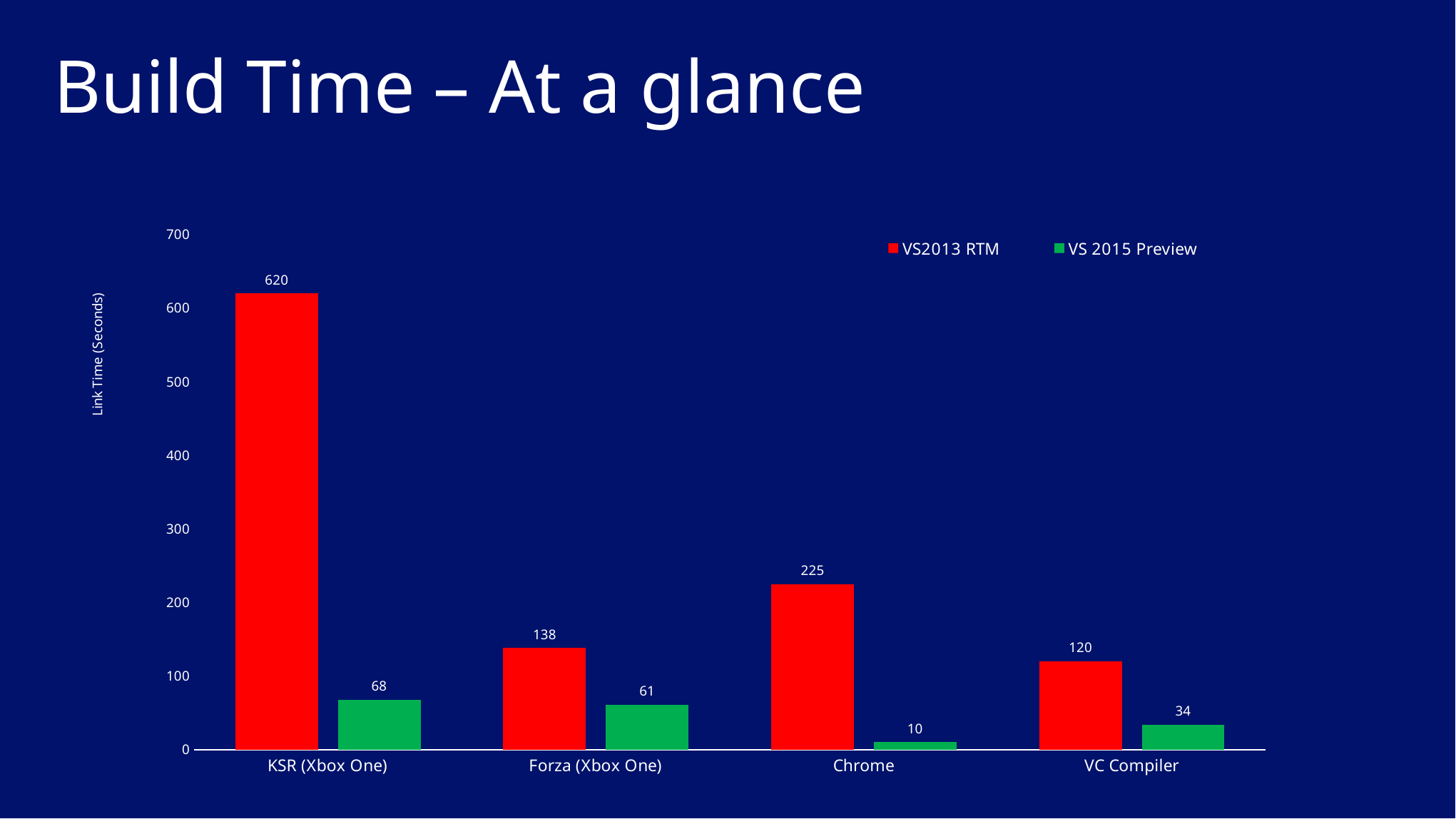
How many series does the legend list? 2 What is the VS 2015 Preview link time for Chrome? 10 What is the VS2013 RTM link time for VC Compiler? 120 Which category has the highest VS2013 RTM link time? KSR (Xbox One) What is the difference between the VS2013 RTM and VS 2015 Preview link times for Forza (Xbox One)? 77 What kind of chart is shown on the slide? Bar chart Is the VS2013 RTM value for Chrome greater or less than 200? greater What is the label of the vertical axis? Link Time (Seconds) Which is larger for Chrome: the VS2013 RTM link time or the VS 2015 Preview link time? VS2013 RTM What is the VS2013 RTM link time for KSR (Xbox One)? 620 Which category has the lowest VS 2015 Preview link time? Chrome How many categories are shown on the x axis? 4